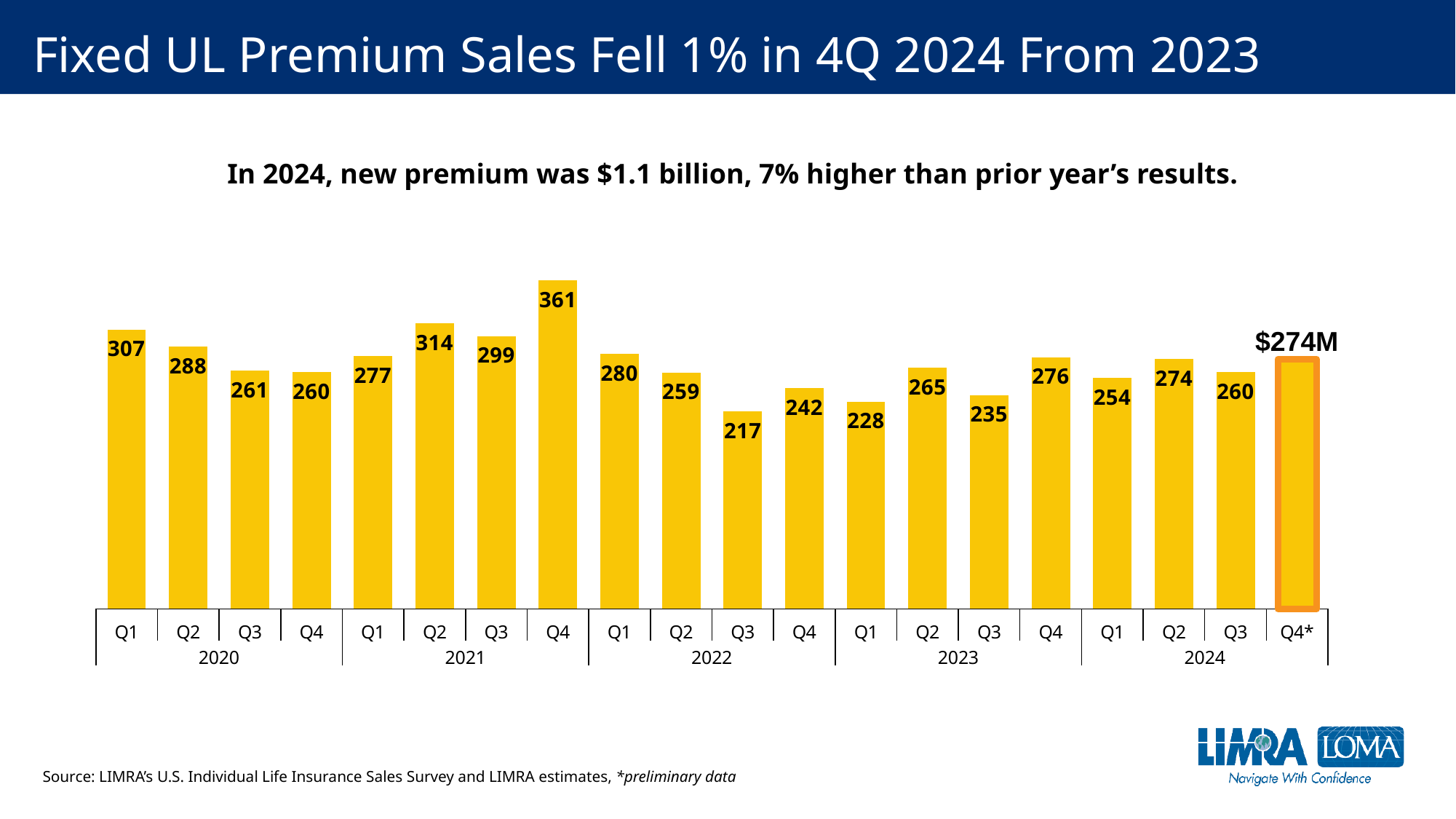
Which is larger, Q2 2021 or Q1 2022? Q2 2021 How many quarterly bars are plotted on the chart? 20 What is the value for Q3 2022? 217 What is the value for Q1 2020? 307 What is the difference between Q4 2023 and Q4 2024? 2 What kind of chart is shown on the slide? Bar chart Which quarter has the highest value? Q4 2021 Do the values rise or fall from Q1 2022 to Q3 2022? Fall Which quarter has the lowest value? Q3 2022 What is the value for Q4 2021? 361 What is the value for Q4 2024? $274M What is the difference between Q4 2021 and Q3 2022? 144